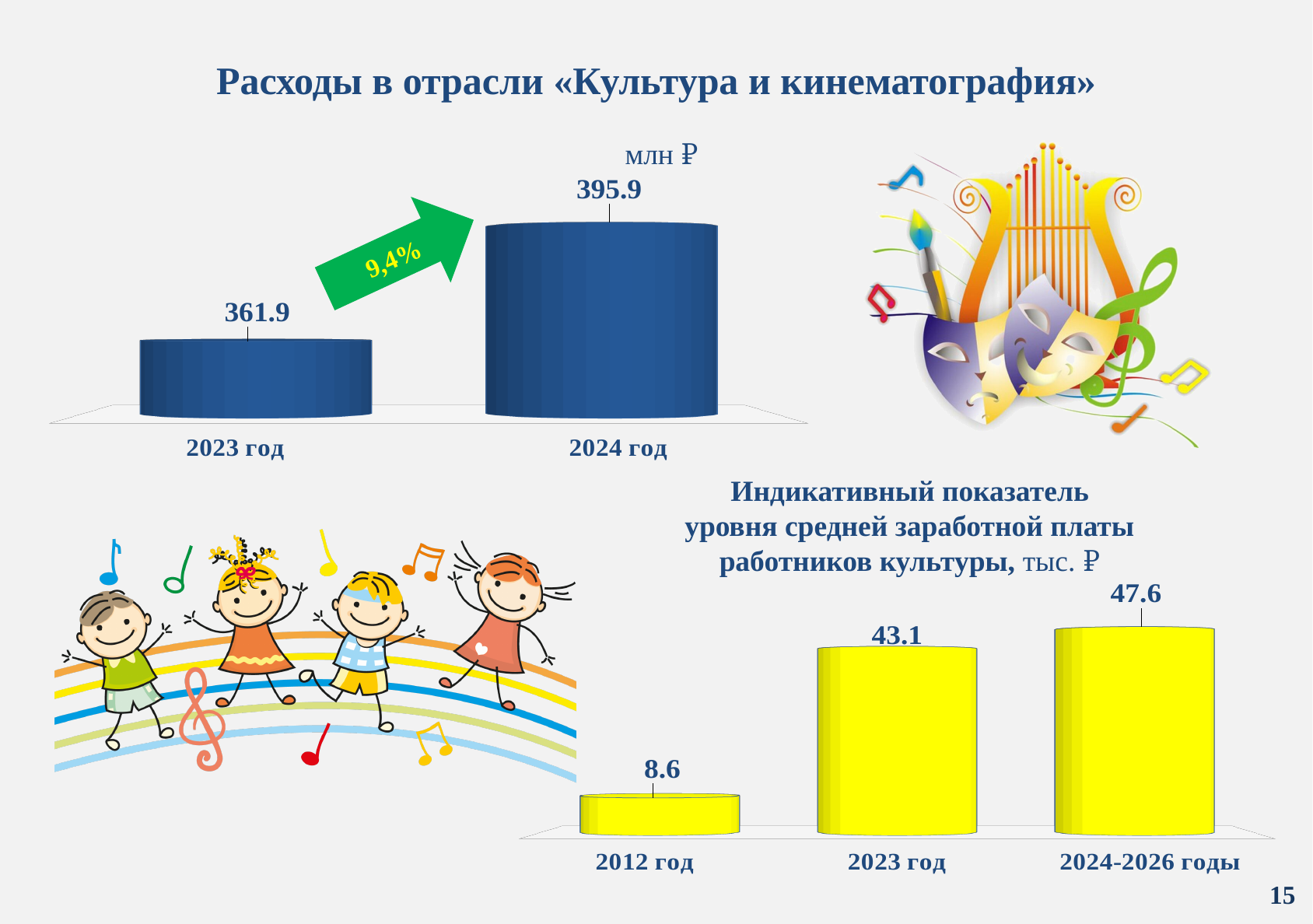
In the bottom-right chart of average salary of culture workers, which period has the lowest value? 2012 год In the top-left chart of expenses in the 'Культура и кинематография' sector, what is the value for 2023 год? 361.9 In the top-left expenses chart, by how much does the 2024 год value exceed the 2023 год value? 34.0 In the bottom-right chart of average salary of culture workers, which period has the highest value? 2024-2026 годы In the bottom-right chart 'Индикативный показатель уровня средней заработной платы работников культуры', what is the value for 2012 год? 8.6 In the bottom-right chart of average salary of culture workers, what is the value for 2023 год? 43.1 In the bottom-right chart of average salary of culture workers, what is the value for 2024-2026 годы? 47.6 In the top-left expenses chart, what percentage growth is shown on the green arrow? 9,4% In the top-left expenses chart, what unit is indicated for the values? млн ₽ In the bottom-right chart of average salary of culture workers, how many categories are shown on the x axis? 3 In the top-left chart of expenses in the 'Культура и кинематография' sector, what is the value for 2024 год? 395.9 In the top-left expenses chart, which year has the higher value, 2023 год or 2024 год? 2024 год